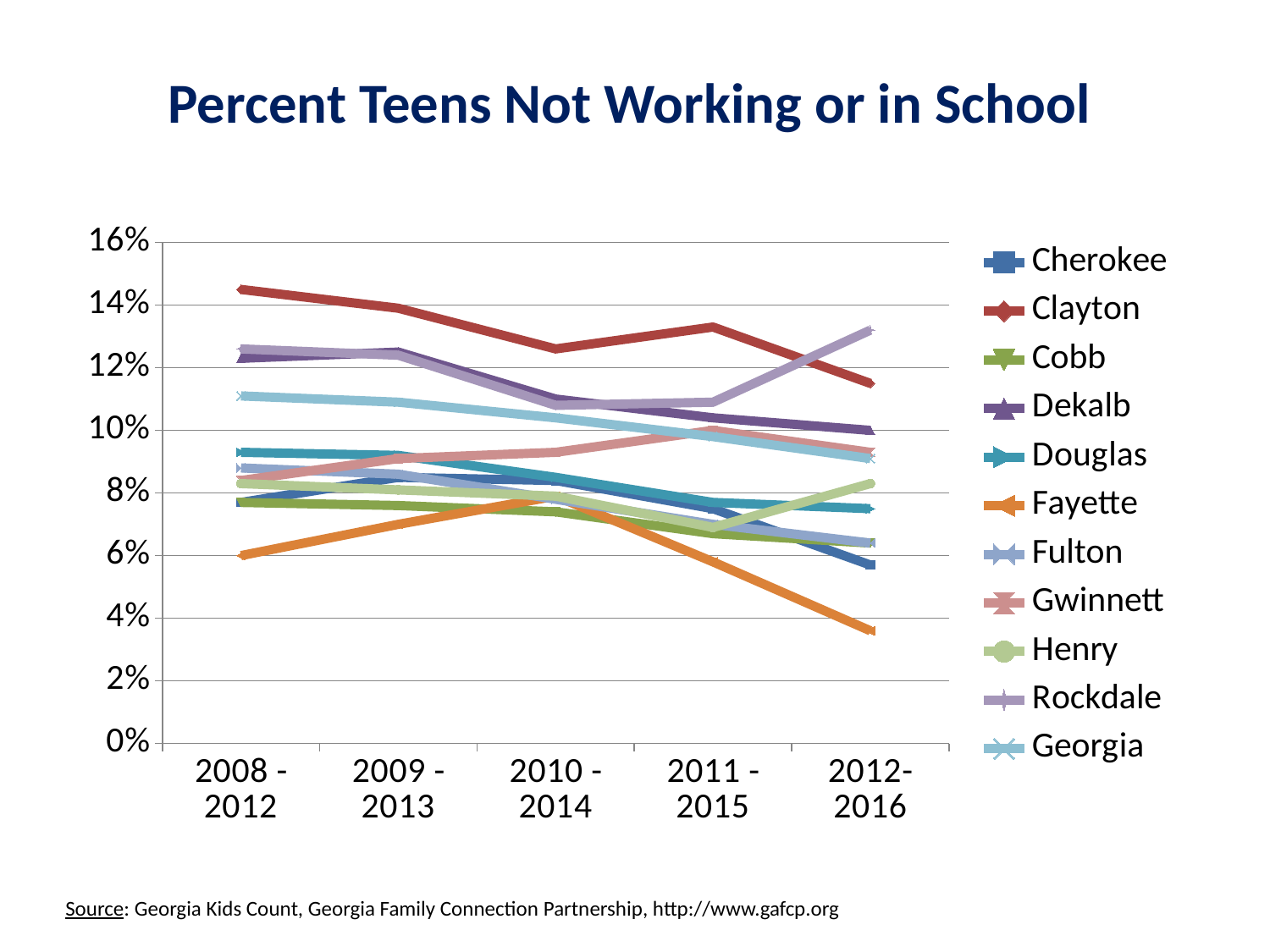
In 2012-2016, which is larger, Rockdale or Clayton? Rockdale Is the value for Clayton in 2008 - 2012 greater or less than 14%? greater Is the value for Fayette in 2012-2016 greater or less than 4%? less Is the value for Georgia in 2008 - 2012 greater or less than 10%? greater Which series has the lowest value in 2012-2016? Fayette How many time periods are shown on the x axis? 5 Which series has the highest value in 2012-2016? Rockdale How many series does the legend list? 11 What kind of chart is shown on the slide? line chart Does the Georgia line rise or fall from 2008 - 2012 to 2012-2016? fall Which series has the lowest value in 2008 - 2012? Fayette Which county has the highest percent of teens not working or in school in 2008 - 2012? Clayton